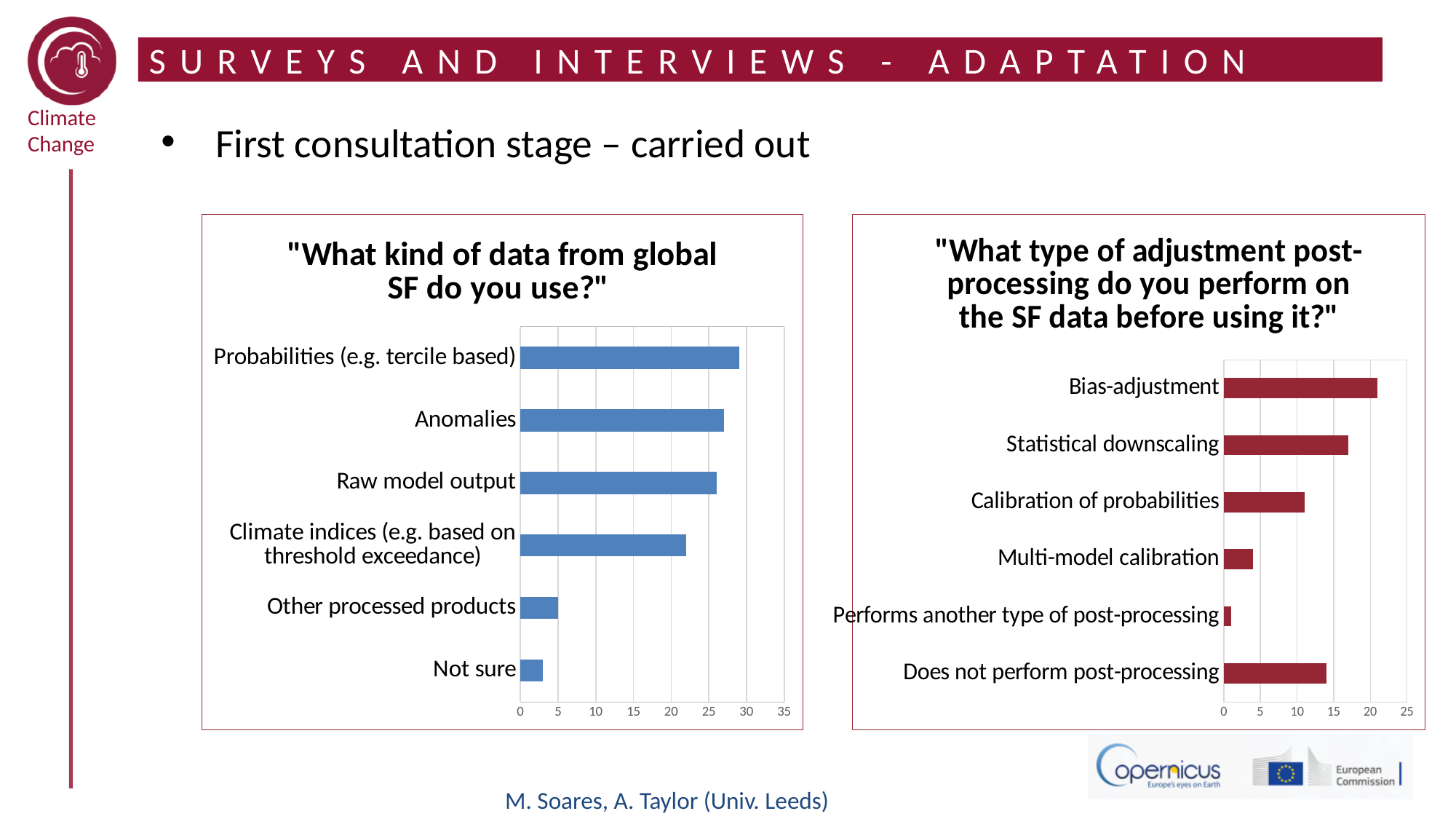
In the chart titled "What kind of data from global SF do you use?", which category has the highest value? Probabilities (e.g. tercile based) In the chart titled "What type of adjustment post-processing do you perform on the SF data before using it?", is the value for Bias-adjustment greater or less than 20? greater In the chart titled "What type of adjustment post-processing do you perform on the SF data before using it?", which is larger: Statistical downscaling or Multi-model calibration? Statistical downscaling What kind of chart is the one titled "What kind of data from global SF do you use?"? Bar chart In the chart titled "What kind of data from global SF do you use?", is the value for Probabilities (e.g. tercile based) greater or less than 25? greater How many categories are shown in the chart titled "What type of adjustment post-processing do you perform on the SF data before using it?"? 6 In the chart titled "What kind of data from global SF do you use?", is the value for Other processed products greater or less than 10? less How many categories are shown in the chart titled "What kind of data from global SF do you use?"? 6 In the chart titled "What type of adjustment post-processing do you perform on the SF data before using it?", which category has the highest value? Bias-adjustment In the chart titled "What kind of data from global SF do you use?", which is larger: Climate indices (e.g. based on threshold exceedance) or Other processed products? Climate indices (e.g. based on threshold exceedance) In the chart titled "What kind of data from global SF do you use?", which category has the lowest value? Not sure In the chart titled "What type of adjustment post-processing do you perform on the SF data before using it?", which category has the lowest value? Performs another type of post-processing